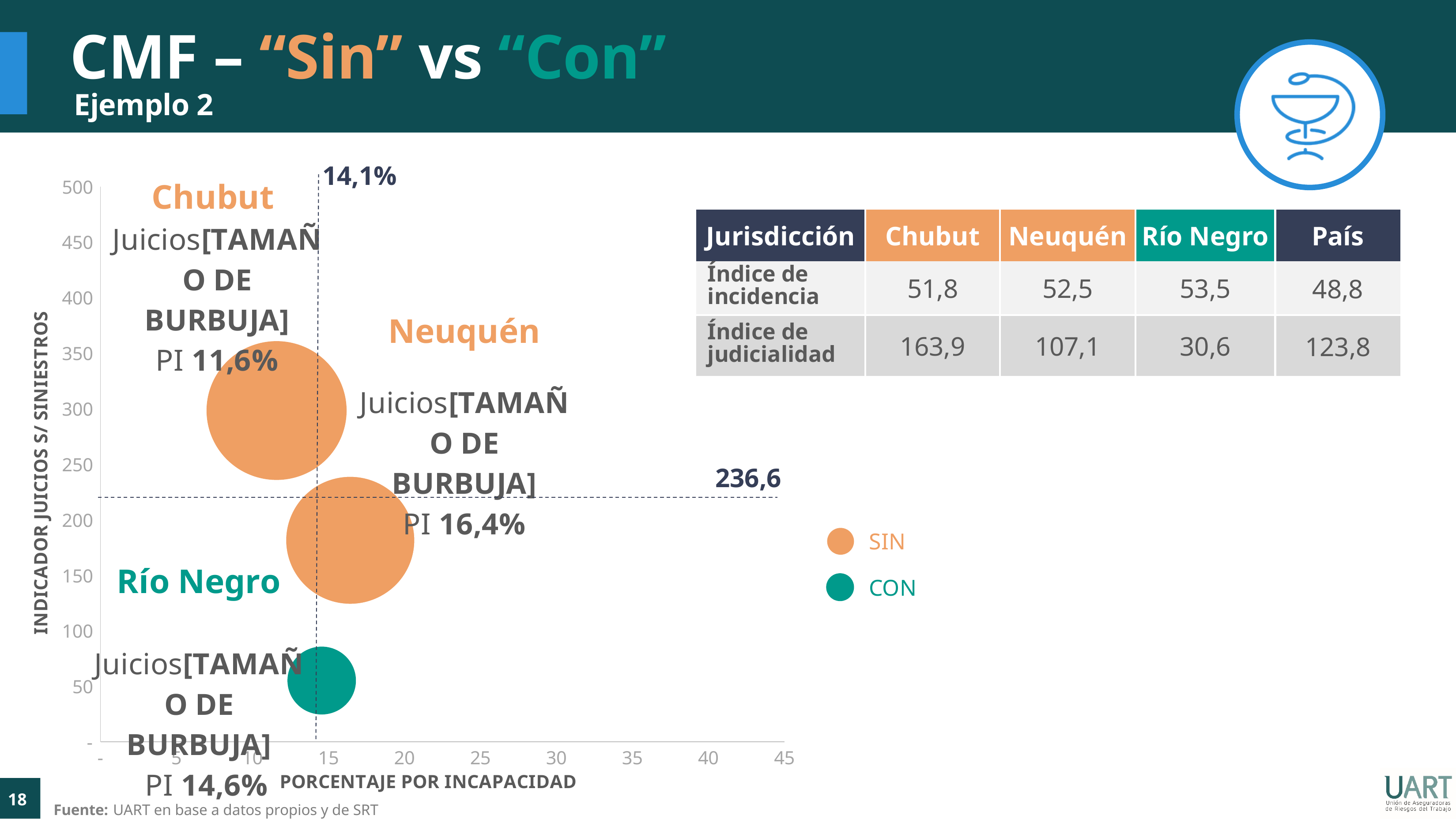
How many series does the chart legend list? 2 Which jurisdiction has the lowest PI value in the chart? Chubut What is the PI value shown for Río Negro? 14,6% Is the indicador juicios s/ siniestros value for Río Negro greater or less than 100? less Is the indicador juicios s/ siniestros value for Chubut greater or less than 250? greater What kind of chart is shown on the slide? bubble chart How many jurisdictions are plotted as bubbles in the chart? 3 What is the PI (porcentaje por incapacidad) value shown for Chubut? 11,6% Which jurisdiction has the highest PI value in the chart? Neuquén What is the difference between the PI values of Neuquén and Chubut? 4,8% What is the PI value shown for Neuquén? 16,4% Which jurisdiction is plotted in the CON series (green bubble)? Río Negro